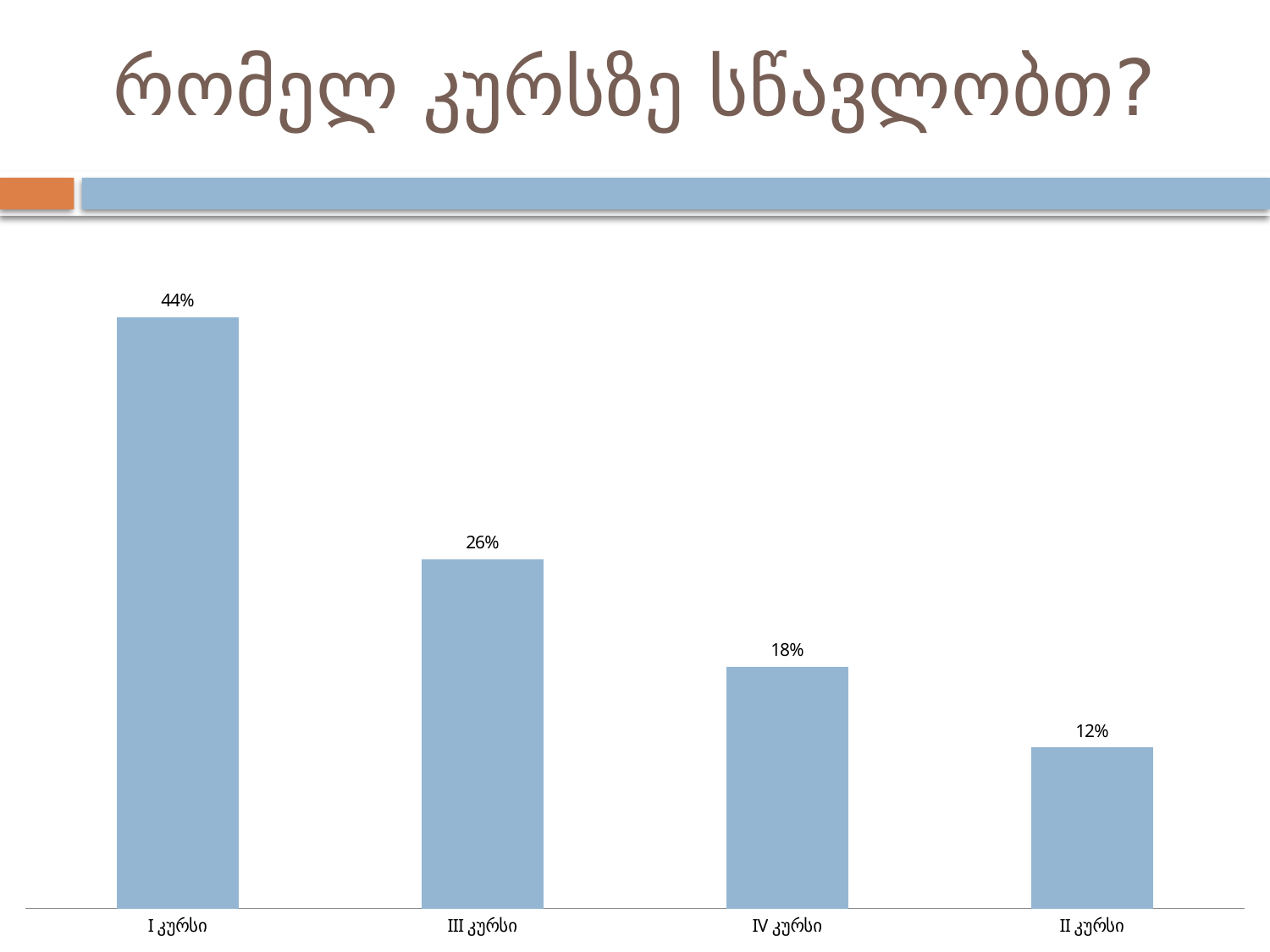
How many categories are shown in the chart? 4 What kind of chart is shown on the slide? bar chart What is the value for III კურსი? 26% What is the value for II კურსი? 12% What is the value for IV კურსი? 18% Which category has the highest value? I კურსი What is the difference between the values for IV კურსი and II კურსი? 6% Which is larger, the value for III კურსი or the value for IV კურსი? III კურსი What is the value for I კურსი? 44% What is the difference between the values for I კურსი and III კურსი? 18% Which category has the lowest value? II კურსი Do the values rise or fall from left to right along the x axis? fall